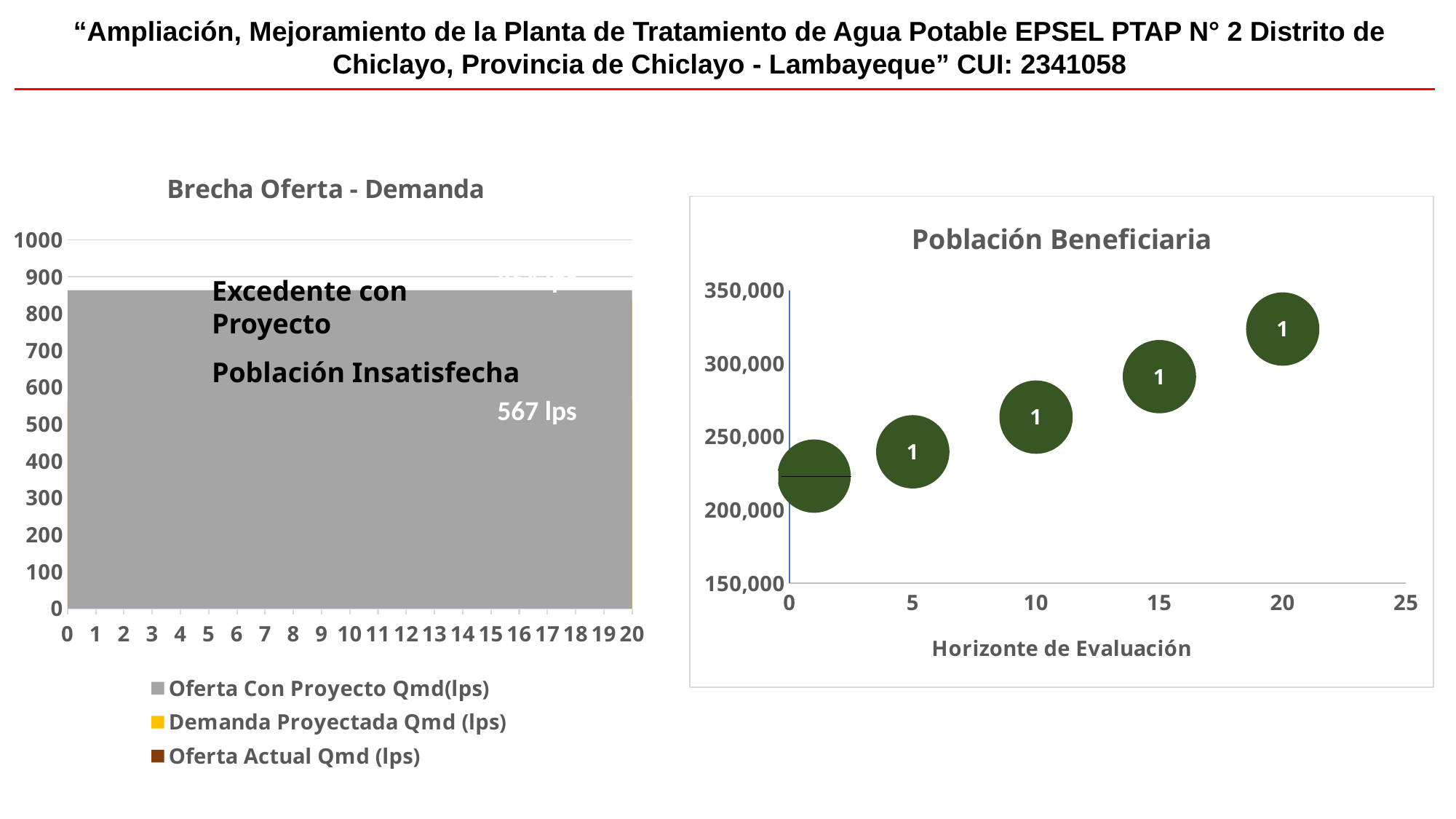
In the 'Población Beneficiaria' chart, how many bubbles are plotted? 5 In the 'Brecha Oferta - Demanda' chart, which legend entry is shown in yellow? Demanda Proyectada Qmd (lps) What kind of chart is the 'Población Beneficiaria' chart? bubble chart In the 'Población Beneficiaria' chart, is the value of the bubble at horizon 20 greater or less than 300,000? greater In the 'Brecha Oferta - Demanda' chart, what value label in lps is printed inside the shaded area? 567 lps In the 'Brecha Oferta - Demanda' chart, is the value of Oferta Con Proyecto Qmd(lps) greater or less than 900? less In the 'Población Beneficiaria' chart, at which horizon value is the population highest? 20 In the 'Brecha Oferta - Demanda' chart, how many series does the legend list? 3 In the 'Brecha Oferta - Demanda' chart, is the value of Oferta Con Proyecto Qmd(lps) greater or less than 800? greater In the 'Población Beneficiaria' chart, do the values rise or fall as the horizon increases? rise What is the x-axis title of the 'Población Beneficiaria' chart? Horizonte de Evaluación